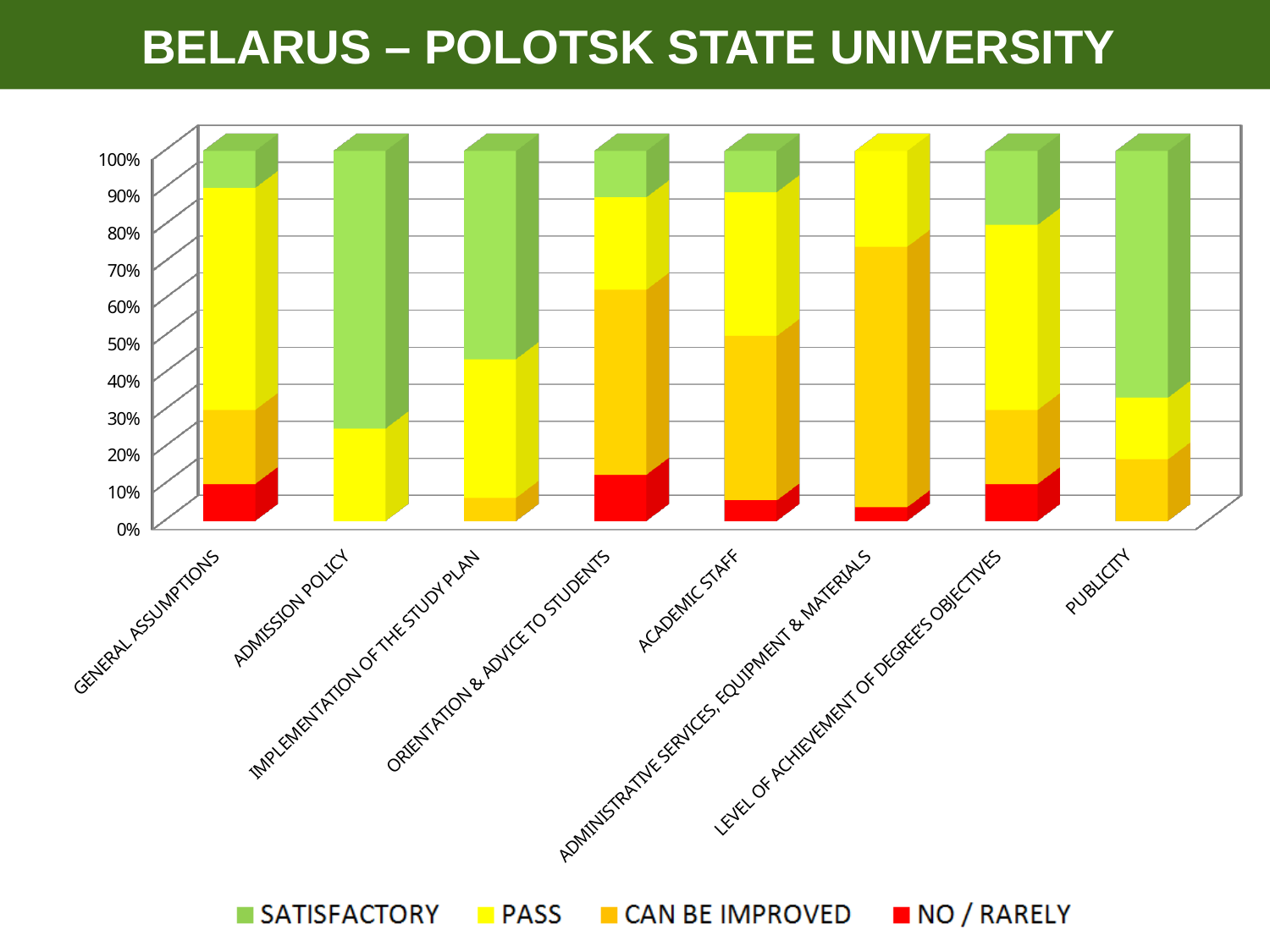
How many categories are shown along the x axis of the chart? 8 Which category has the largest CAN BE IMPROVED share? ADMINISTRATIVE SERVICES, EQUIPMENT & MATERIALS Which has the larger NO / RARELY share, ORIENTATION & ADVICE TO STUDENTS or ACADEMIC STAFF? ORIENTATION & ADVICE TO STUDENTS Is the NO / RARELY share for ACADEMIC STAFF greater or less than 10%? less Is the SATISFACTORY share for PUBLICITY greater or less than 50%? greater Which series is shown in red in the chart legend? NO / RARELY What kind of chart is shown on the slide? Stacked bar chart Is the CAN BE IMPROVED share for ADMINISTRATIVE SERVICES, EQUIPMENT & MATERIALS greater or less than 50%? greater Which category has the largest SATISFACTORY share? ADMISSION POLICY How many series does the chart legend list? 4 Which has the larger SATISFACTORY share, ADMISSION POLICY or PUBLICITY? ADMISSION POLICY